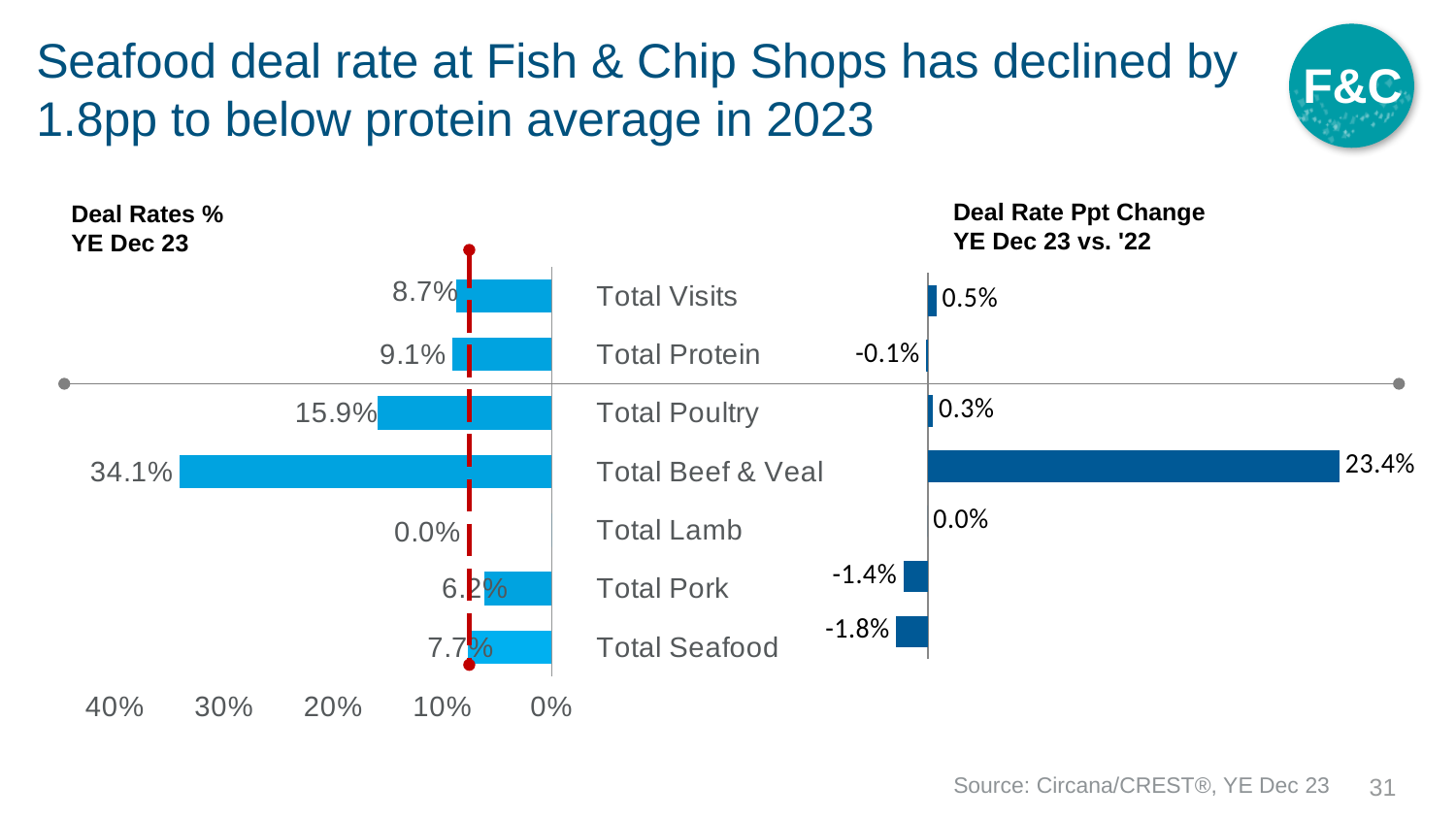
In the 'Deal Rates % YE Dec 23' chart, what is the deal rate for Total Poultry? 15.9% In the 'Deal Rates % YE Dec 23' chart, which category has the lowest deal rate? Total Lamb In the 'Deal Rates % YE Dec 23' chart, what is the deal rate for Total Seafood? 7.7% In the 'Deal Rate Ppt Change YE Dec 23 vs. '22' chart, what is the change for Total Pork? -1.4% In the 'Deal Rates % YE Dec 23' chart, which category has the highest deal rate? Total Beef & Veal In the 'Deal Rate Ppt Change YE Dec 23 vs. '22' chart, which category has the lowest change? Total Seafood In the 'Deal Rates % YE Dec 23' chart, what is the deal rate for Total Beef & Veal? 34.1% In the 'Deal Rate Ppt Change YE Dec 23 vs. '22' chart, what is the change for Total Beef & Veal? 23.4% How many categories are shown in the 'Deal Rates % YE Dec 23' chart? 7 In the 'Deal Rates % YE Dec 23' chart, what is the difference between the deal rates for Total Protein and Total Seafood? 1.4% In the 'Deal Rate Ppt Change YE Dec 23 vs. '22' chart, what is the change for Total Seafood? -1.8% What kind of chart is the 'Deal Rate Ppt Change YE Dec 23 vs. '22' chart? Bar chart